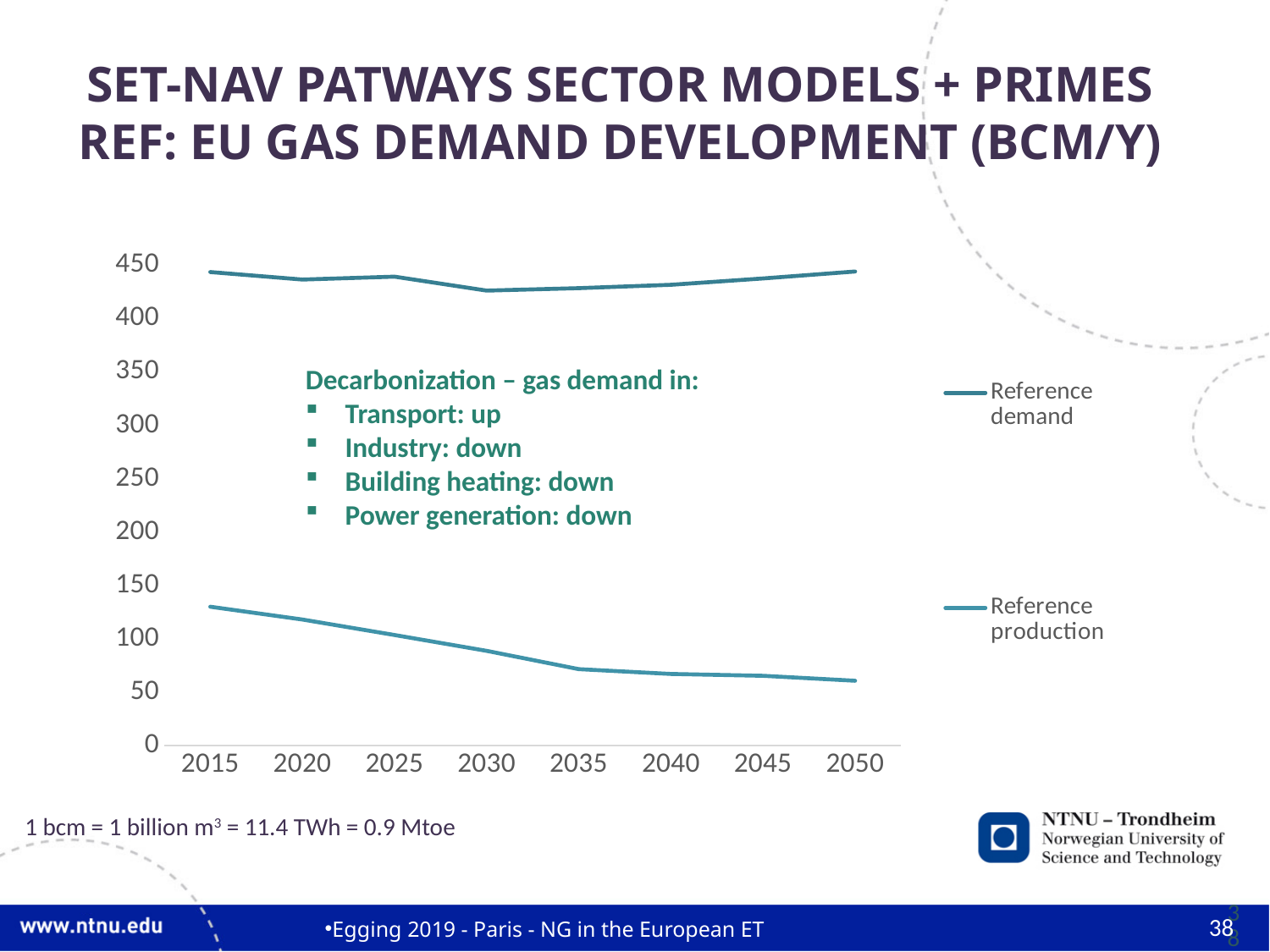
Which series has the larger value in 2050, Reference demand or Reference production? Reference demand Is the value for Reference production in 2050 greater or less than 100? less How many series does the chart legend list? 2 Is the value for Reference production in 2035 greater or less than 100? less What kind of chart is shown on the slide? line chart How many years are shown along the x axis of the chart? 8 Does the Reference production line rise or fall from 2015 to 2050? fall Is the value for Reference production in 2015 greater or less than 100? greater In which year is Reference production at its highest? 2015 What are the two series named in the chart legend? Reference demand and Reference production What is the first year shown on the x axis of the chart? 2015